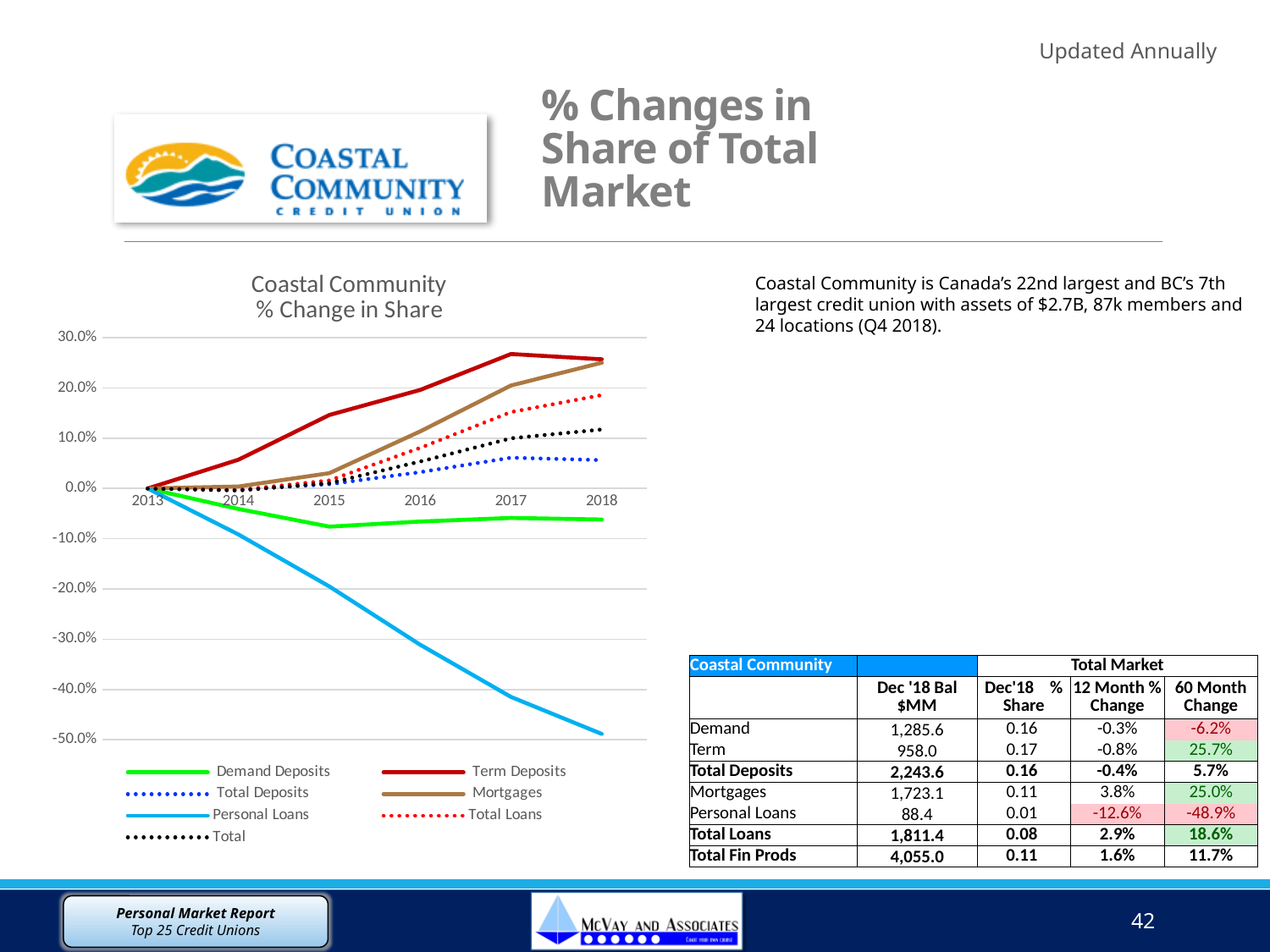
Is the value for Term Deposits in 2017 greater or less than 20.0%? greater In 2015, which is larger: Term Deposits or Mortgages? Term Deposits Is the value for Total Deposits in 2018 greater or less than 10.0%? less Which series has the highest value in 2017? Term Deposits Is the value for Personal Loans in 2018 greater or less than -40.0%? less What kind of chart is shown on the slide? line chart Which series has the lowest value in 2018? Personal Loans How many years are plotted along the x axis of the chart? 6 What is the title of the chart? Coastal Community % Change in Share How many series does the chart legend list? 7 Does the Personal Loans line rise or fall from 2013 to 2018? fall